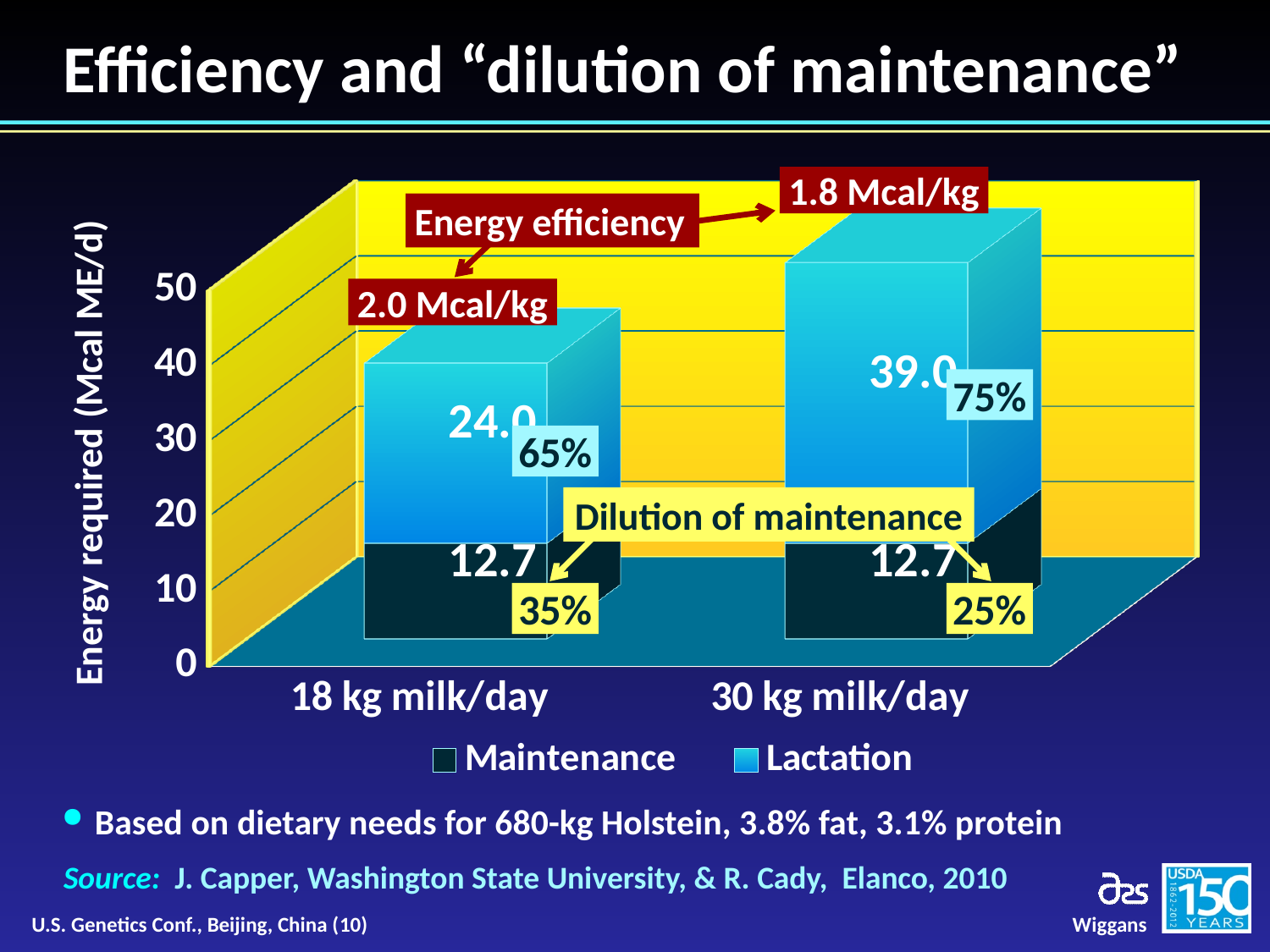
How many categories are shown on the x axis? 2 What kind of chart is shown on the slide? stacked bar chart What is the total energy required for the 30 kg milk/day bar? 51.7 What is the Lactation value for 30 kg milk/day? 39.0 What is the difference between the Lactation values for 30 kg milk/day and 18 kg milk/day? 15.0 What is the Lactation value for 18 kg milk/day? 24.0 What energy efficiency value is labelled for the 30 kg milk/day bar? 1.8 Mcal/kg Is the Lactation value for 30 kg milk/day larger or smaller than the Lactation value for 18 kg milk/day? larger Which category has the higher Lactation value? 30 kg milk/day How many series does the legend list? 2 What is the total energy required for the 18 kg milk/day bar? 36.7 What is the Maintenance value for 30 kg milk/day? 12.7